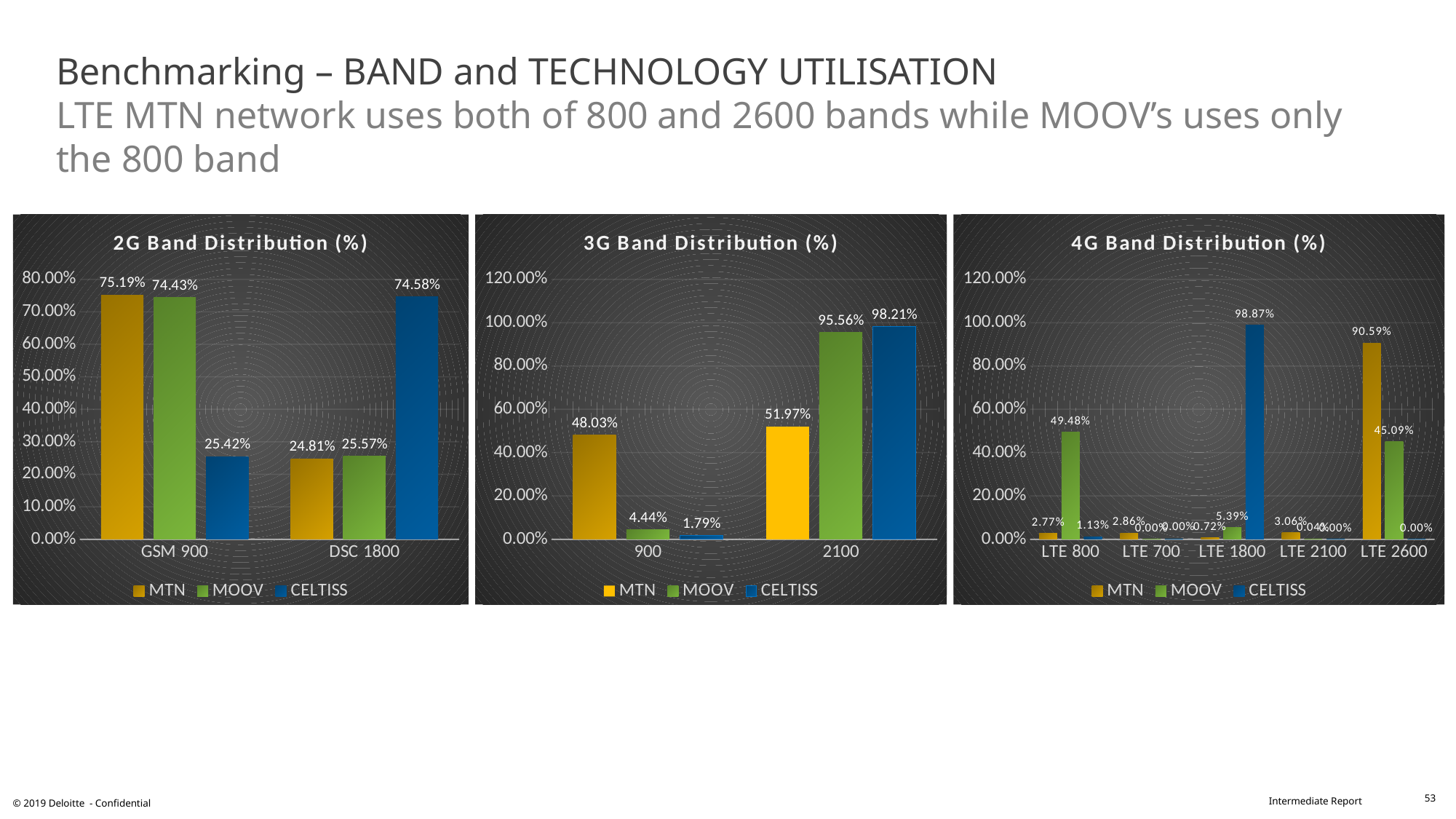
In the 2G Band Distribution (%) chart, what is the value for CELTISS at DSC 1800? 74.58% How many series does the legend of the 3G Band Distribution (%) chart list? 3 In the 4G Band Distribution (%) chart, what is the value for MTN at LTE 2600? 90.59% What type of chart is the 4G Band Distribution (%) chart? bar chart In the 4G Band Distribution (%) chart, what is the value for CELTISS at LTE 1800? 98.87% In the 3G Band Distribution (%) chart, which series has the lowest value at 900? CELTISS In the 3G Band Distribution (%) chart, is the MTN value at 2100 larger or smaller than the MOOV value at 2100? smaller In the 3G Band Distribution (%) chart, what is the value for MOOV at 2100? 95.56% In the 2G Band Distribution (%) chart, which series has the highest value at DSC 1800? CELTISS In the 2G Band Distribution (%) chart, what is the value for MTN at GSM 900? 75.19% In the 2G Band Distribution (%) chart, what is the difference between the MTN and CELTISS values at GSM 900? 49.77% In the 4G Band Distribution (%) chart, how many band categories are shown on the x axis? 5